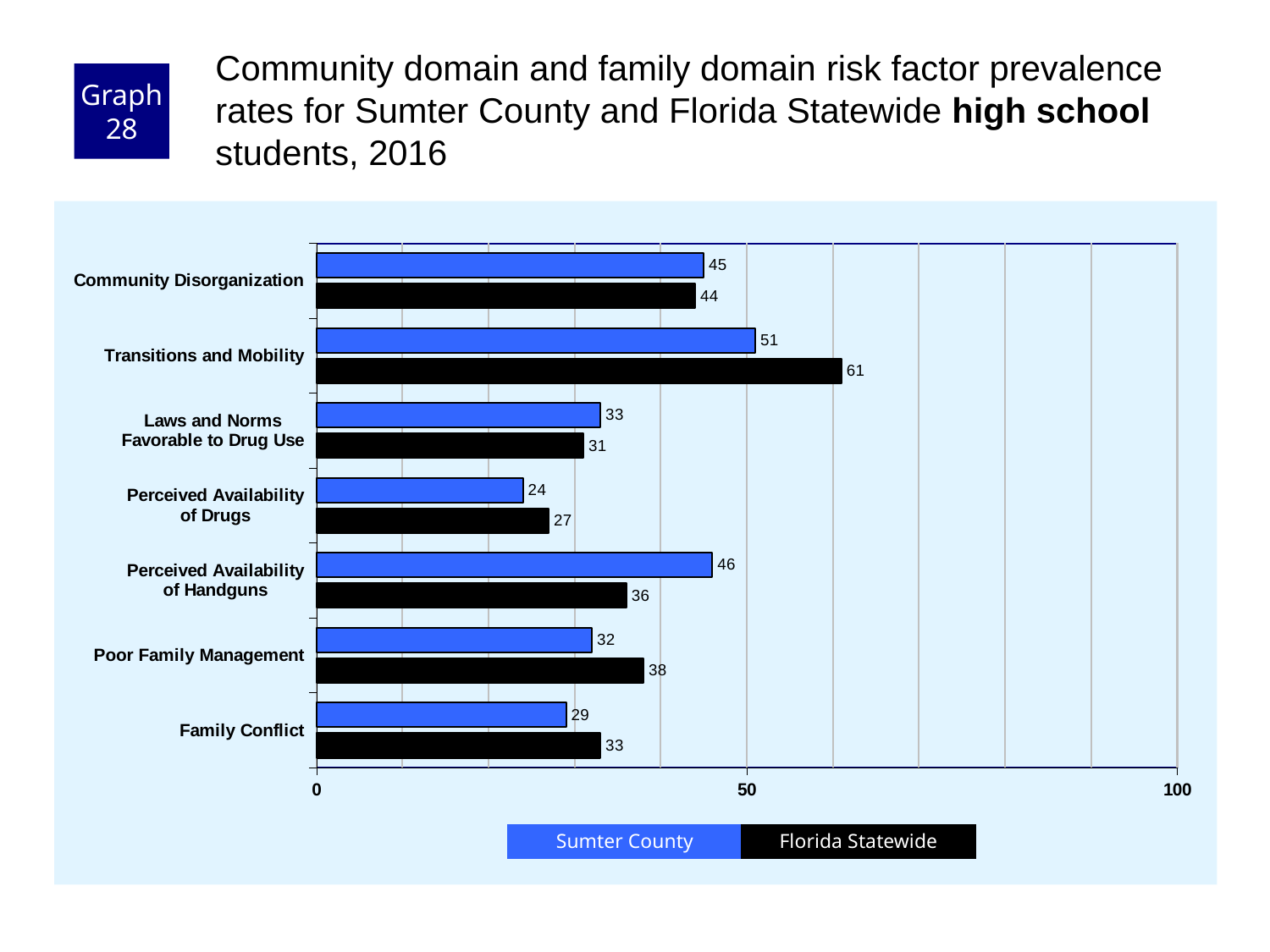
Which risk factor has the highest Florida Statewide value? Transitions and Mobility Which is larger for Poor Family Management: the Sumter County value or the Florida Statewide value? Florida Statewide What is the Florida Statewide value for Perceived Availability of Handguns? 36 What is the difference between the Florida Statewide and Sumter County values for Transitions and Mobility? 10 What is the Sumter County value for Family Conflict? 29 Which risk factor has the lowest Sumter County value? Perceived Availability of Drugs Is the Florida Statewide value for Transitions and Mobility greater or less than 50? greater How many risk factor categories are shown on the chart? 7 What kind of chart is shown on the slide? Bar chart Which colour represents Sumter County in the chart? Blue What is the Sumter County value for Transitions and Mobility? 51 How many series does the legend list? 2